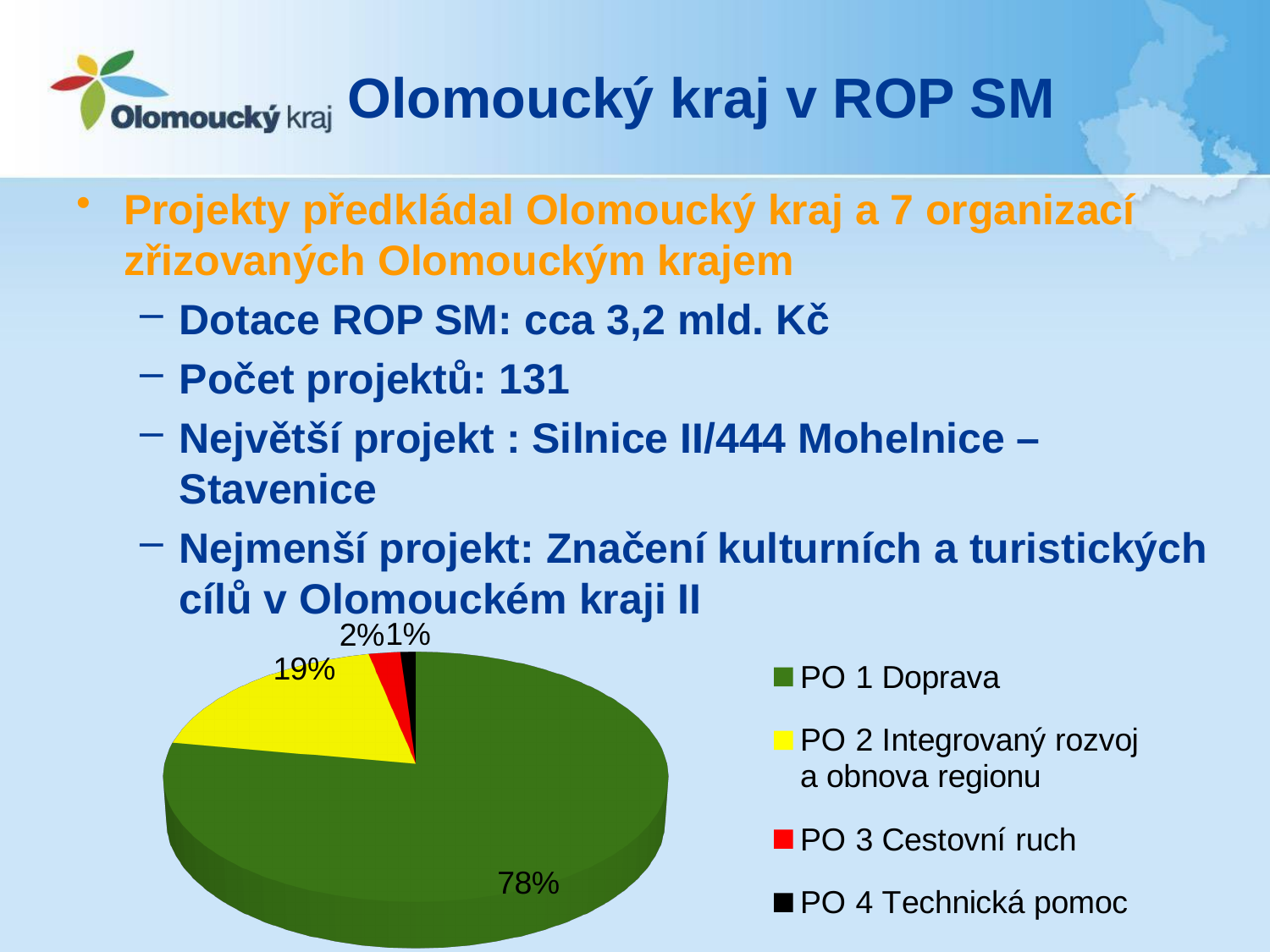
How many entries does the legend list? 4 What is the difference in percentage points between PO 1 Doprava and PO 2 Integrovaný rozvoj a obnova regionu? 59 Which is larger, the slice for PO 3 Cestovní ruch or the slice for PO 4 Technická pomoc? PO 3 Cestovní ruch What colour is the slice for PO 2 Integrovaný rozvoj a obnova regionu? yellow What share of the pie does PO 1 Doprava have? 78% What kind of chart is shown on the slide? pie chart What share of the pie does PO 3 Cestovní ruch have? 2% How many slices does the pie chart have? 4 What share of the pie does PO 4 Technická pomoc have? 1% Which category has the largest slice of the pie? PO 1 Doprava Which category has the smallest slice of the pie? PO 4 Technická pomoc